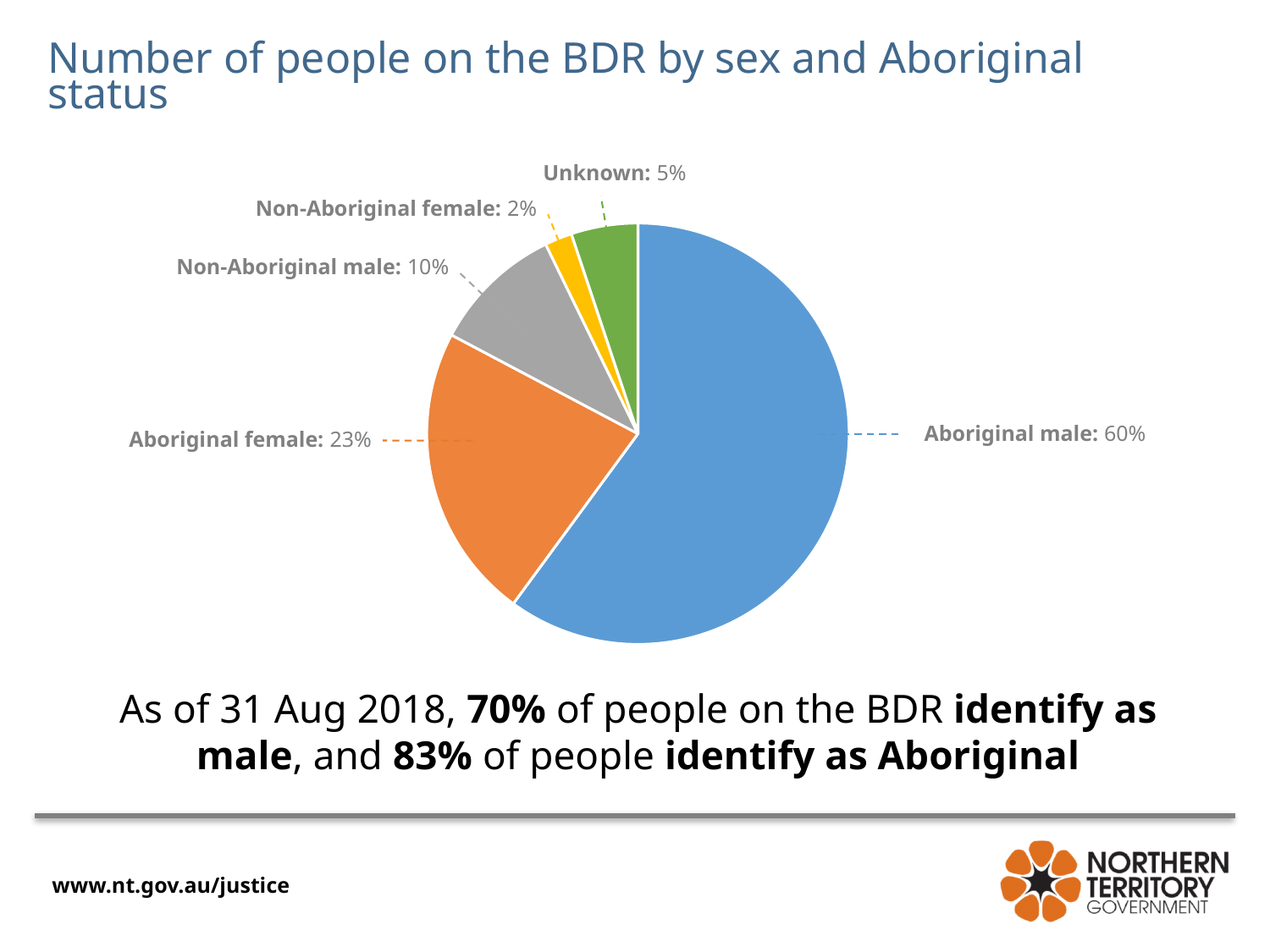
Which is larger, the Non-Aboriginal male slice or the Unknown slice? Non-Aboriginal male How many slices does the pie chart have? 5 What kind of chart is shown on the slide? Pie chart Which category has the smallest slice of the pie? Non-Aboriginal female Which category has the largest slice of the pie? Aboriginal male What share of people on the BDR have Unknown sex and Aboriginal status? 5% What is the title of the chart on the slide? Number of people on the BDR by sex and Aboriginal status What share of people on the BDR are Non-Aboriginal female? 2% What share of people on the BDR are Aboriginal male? 60% What is the difference in percentage points between the Aboriginal male and Aboriginal female slices? 37